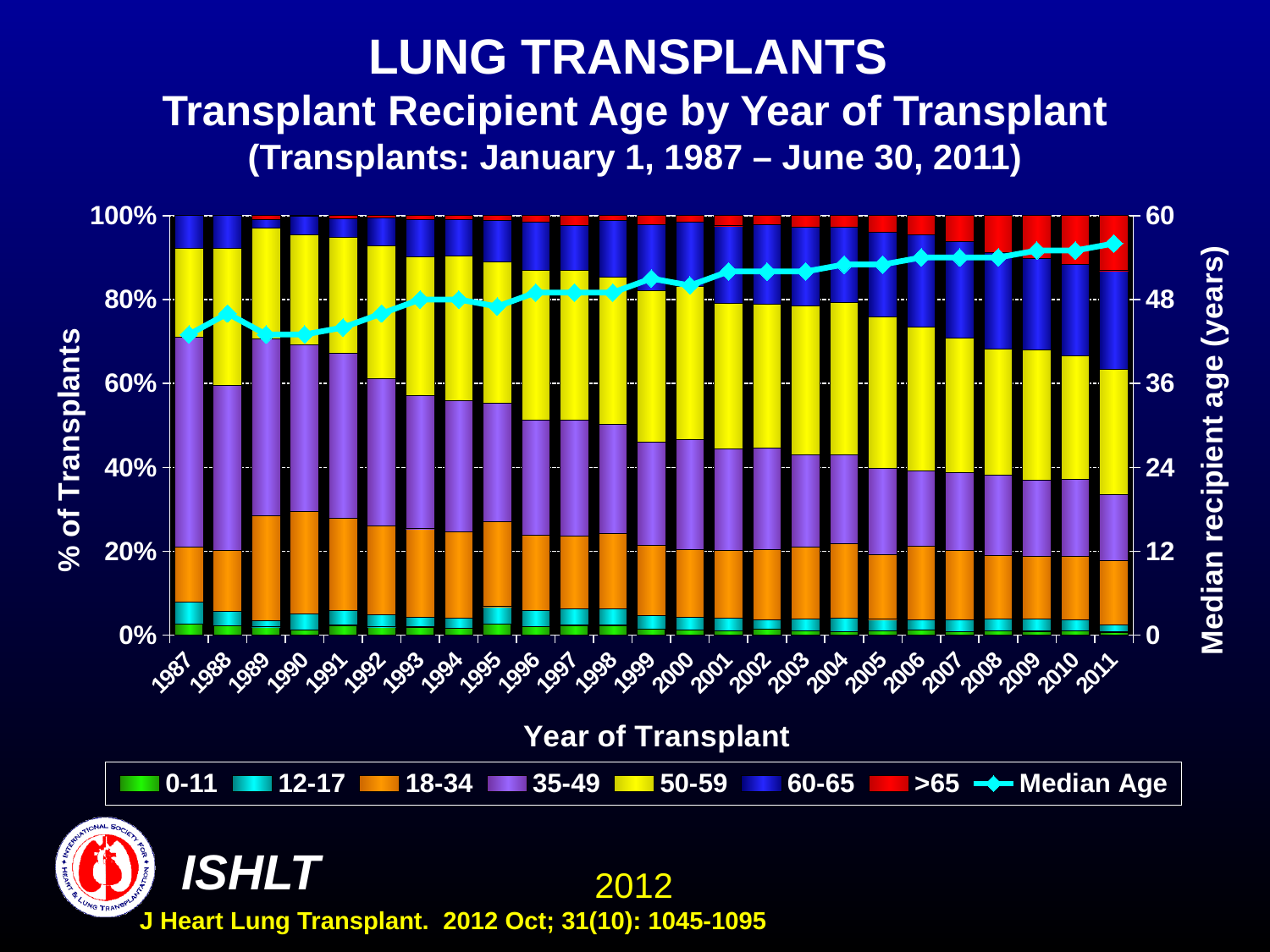
How many entries does the legend list? 8 Which year has the larger median recipient age, 1987 or 2011? 2011 Is the share of the >65 age group in 2011 greater or less than 20%? less What is the label of the right-hand y axis? Median recipient age (years) What is the label of the x axis? Year of Transplant How many years of transplant are shown along the x axis? 25 Is the share of the 35-49 age group in 1987 greater or less than 40%? greater What kind of chart is shown on the slide? Stacked bar chart with a line for median age Is the median recipient age in 1987 greater or less than 48 years? less Which year has the highest median recipient age? 2011 Does the median recipient age rise or fall from 1987 to 2011? rise